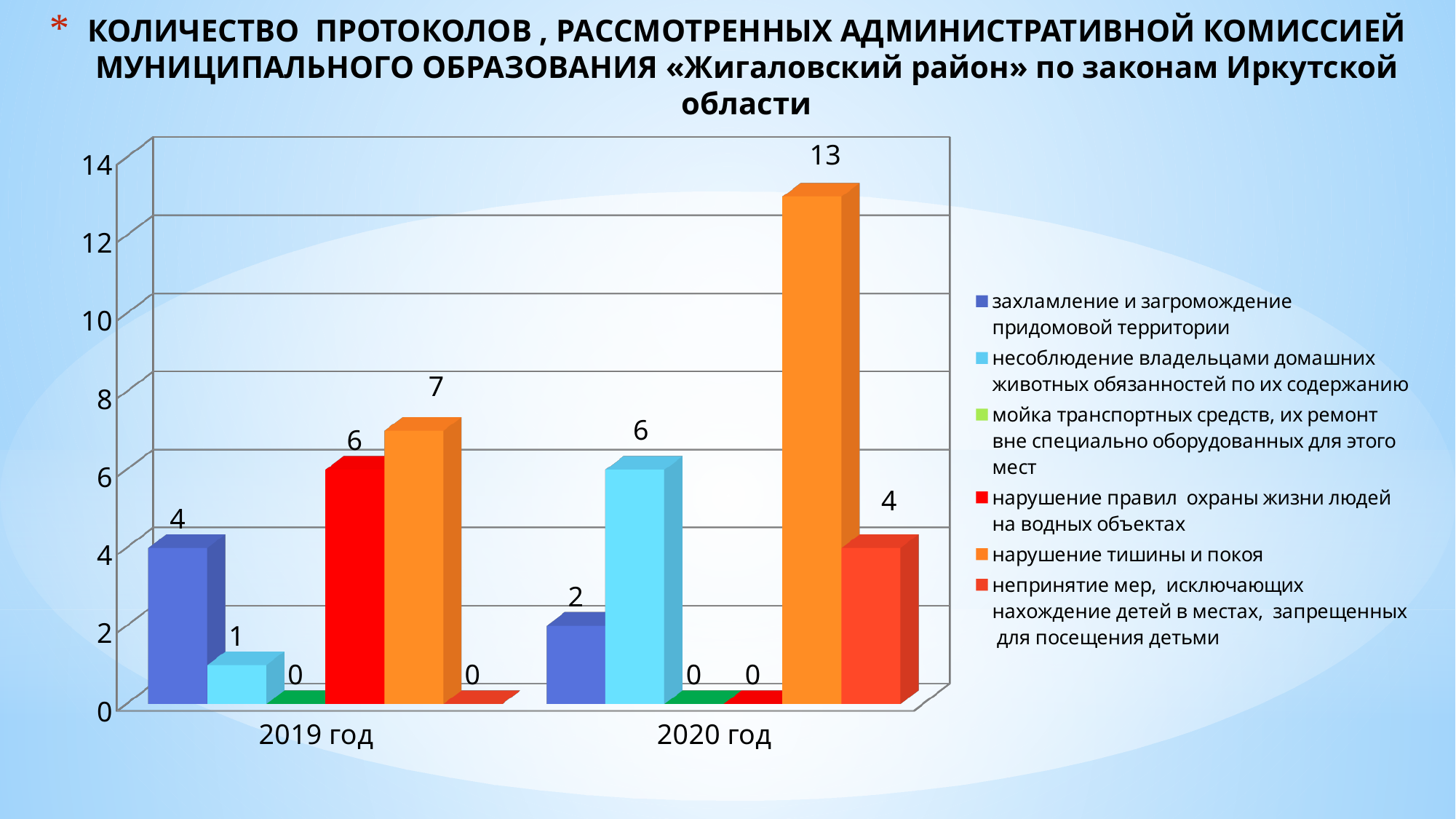
Which is larger: «захламление и загромождение придомовой территории» in 2019 год or in 2020 год? 2019 год What is the difference between the «нарушение тишины и покоя» values for 2020 год and 2019 год? 6 What is the value for «непринятие мер, исключающих нахождение детей в местах, запрещенных для посещения детьми» in 2020 год? 4 What is the value for «нарушение правил охраны жизни людей на водных объектах» in 2019 год? 6 What is the value for «захламление и загромождение придомовой территории» in 2019 год? 4 Which series has the highest value in 2020 год? нарушение тишины и покоя What is the value for «несоблюдение владельцами домашних животных обязанностей по их содержанию» in 2020 год? 6 What is the value for «нарушение тишины и покоя» in 2020 год? 13 How many series does the legend list? 6 What kind of chart is shown on the slide? bar chart How many year categories are shown on the x axis? 2 Which series has the highest value in 2019 год? нарушение тишины и покоя